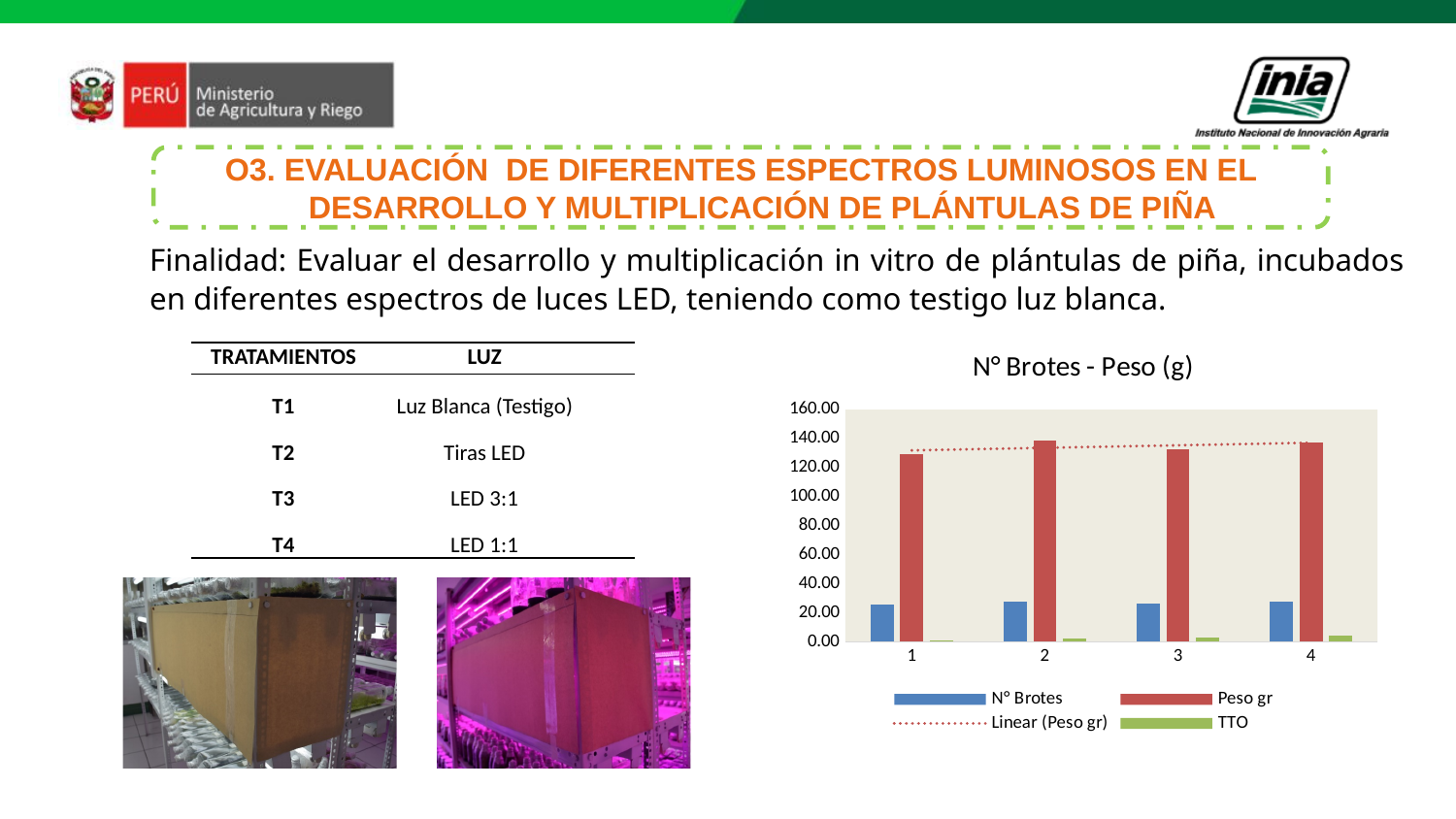
Which category has the lowest Peso gr value? 1 Does the Linear (Peso gr) trendline rise or fall from left to right? rise Is the Peso gr value for category 3 greater or less than 100? greater Is the N° Brotes value for category 1 greater or less than 40? less What kind of chart is shown on the slide? bar chart What is the title of the chart? N° Brotes - Peso (g) How many entries does the chart legend list? 4 What colour are the Peso gr bars in the chart? red How many categories are shown on the x axis of the chart? 4 For category 1, which is larger: N° Brotes or Peso gr? Peso gr Is the Peso gr value for category 2 greater or less than 120? greater